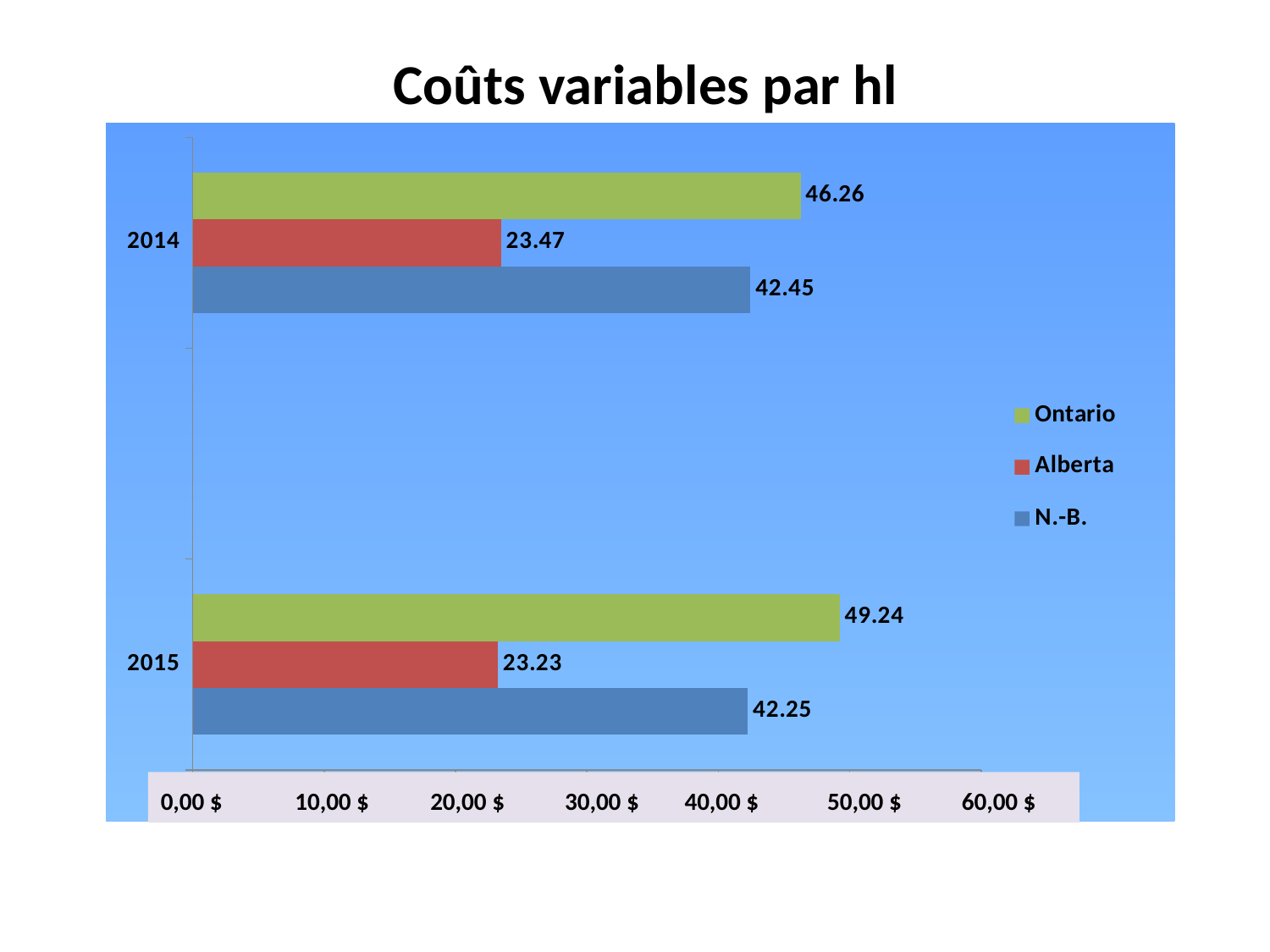
Which is larger, the N.-B. value in 2014 or the N.-B. value in 2015? 2014 What is the value for N.-B. in 2014? 42.45 Which series has the highest value in 2015? Ontario Is the value for Ontario in 2015 greater or less than 40,00 $? greater What kind of chart is shown on the slide? bar chart What is the title of the chart? Coûts variables par hl Which series has the lowest value in 2014? Alberta What is the value for Alberta in 2015? 23.23 What is the difference between the Ontario and N.-B. values in 2014? 3.81 What is the difference between the Ontario values for 2015 and 2014? 2.98 How many series does the legend list? 3 What is the value for Ontario in 2014? 46.26